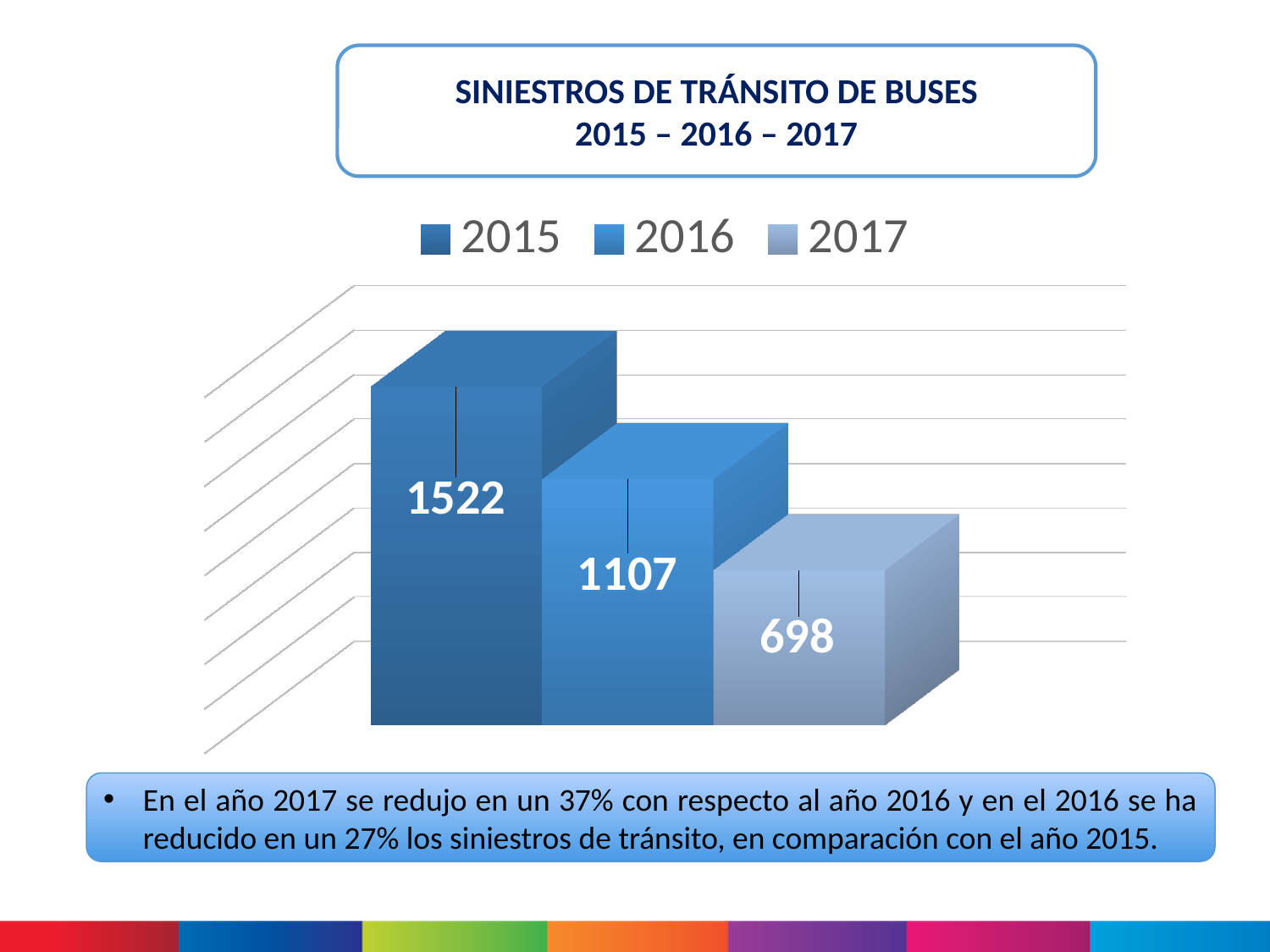
What is the title of the chart? SINIESTROS DE TRÁNSITO DE BUSES 2015 – 2016 – 2017 What kind of chart is shown? bar chart How many series does the legend list? 3 What is the value for 2016? 1107 Which year has the lowest value? 2017 Which is larger, the value for 2016 or the value for 2017? 2016 What is the value for 2015? 1522 Which year has the highest value? 2015 What is the value for 2017? 698 What is the difference between the values for 2015 and 2016? 415 What is the difference between the values for 2016 and 2017? 409 Do the values rise or fall from 2015 to 2017? fall